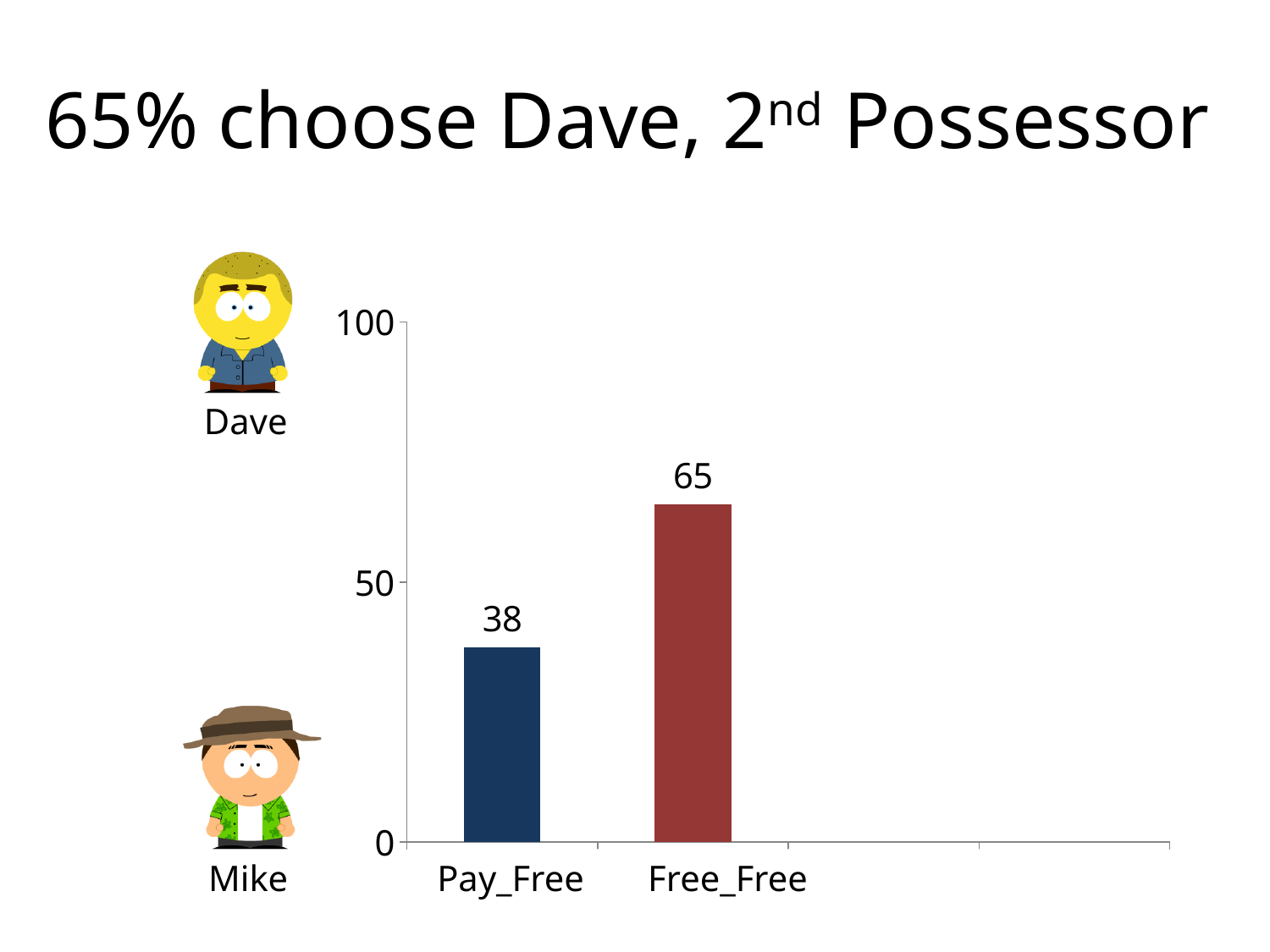
What is the value for Free_Free? 65 What is the value for Pay_Free? 38 What is the difference between the values for Free_Free and Pay_Free? 27 Do the values rise or fall from Pay_Free to Free_Free? rise How many categories are shown on the x axis? 2 What colour is the bar for Free_Free? red Which category has the lowest value? Pay_Free Which is larger, the value for Pay_Free or the value for Free_Free? Free_Free Is the value for Pay_Free greater or less than 50? less Is the value for Free_Free greater or less than 50? greater What kind of chart is shown on the slide? bar chart Which category has the highest value? Free_Free